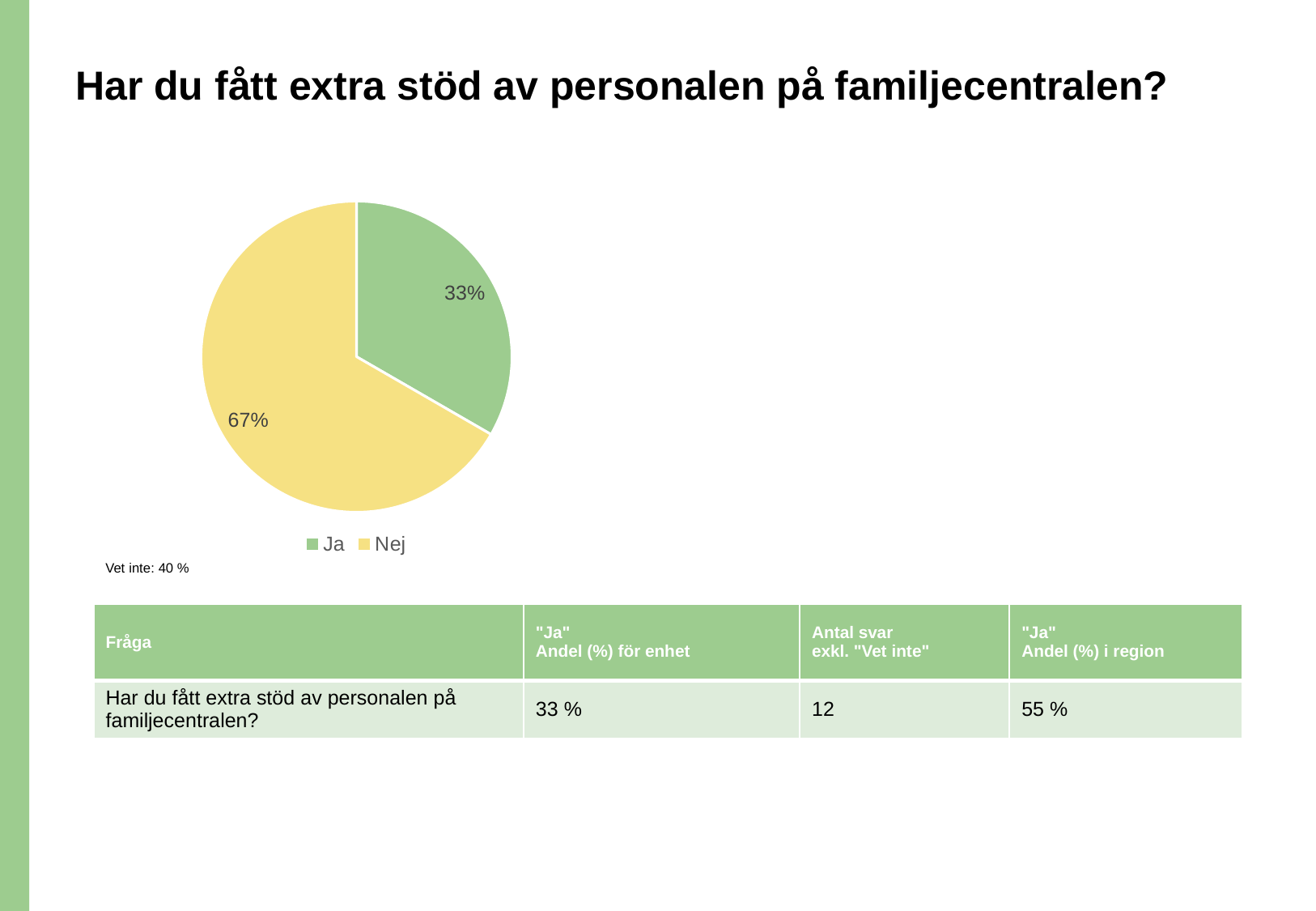
What colour is the "Nej" slice in the pie chart? yellow What colour is the "Ja" slice in the pie chart? green Which slice of the pie is the smallest? Ja Which is larger, the "Ja" slice or the "Nej" slice? Nej Which slice of the pie is the largest? Nej What is the difference in percentage points between the "Nej" and "Ja" slices? 34 How many entries does the legend list? 2 What kind of chart is shown on the slide? pie chart How many slices does the pie chart have? 2 What share of the pie does the "Ja" slice represent? 33% What share of the pie does the "Nej" slice represent? 67%